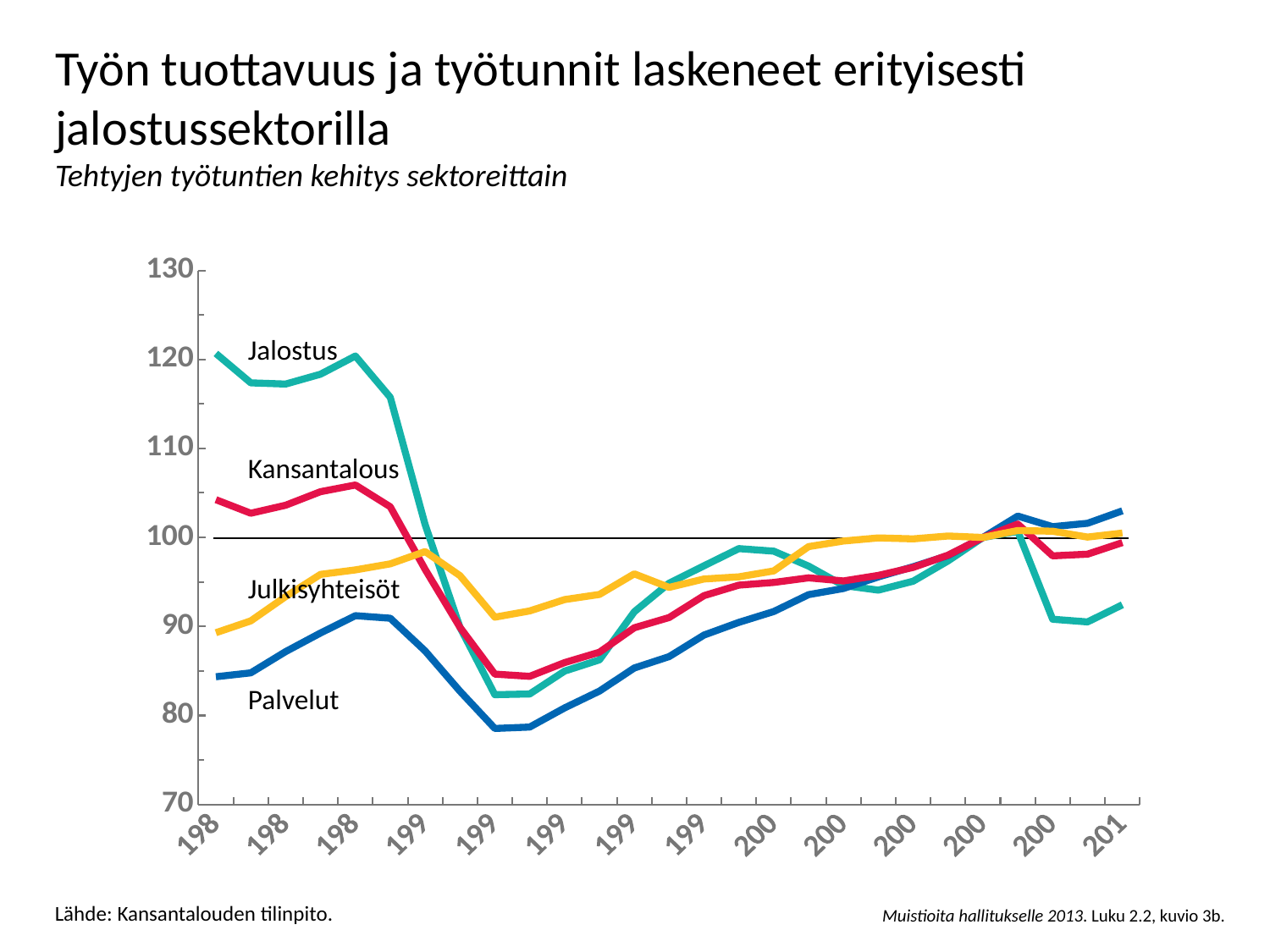
Is the starting value of Jalostus greater or less than 110? greater Is the final value of Jalostus greater or less than 100? less Does the Jalostus line overall rise or fall from the start to the end of the chart? fall Which series has the lowest value at the end of the chart? Jalostus Which series has the highest value at the start of the chart? Jalostus Is the starting value of Palvelut greater or less than 90? less What is the subtitle of the chart? Tehtyjen työtuntien kehitys sektoreittain At the start of the chart, which is higher: Kansantalous or Julkisyhteisöt? Kansantalous Which series has the lowest value at the start of the chart? Palvelut What kind of chart is shown on the slide? line chart How many series are plotted in the chart? 4